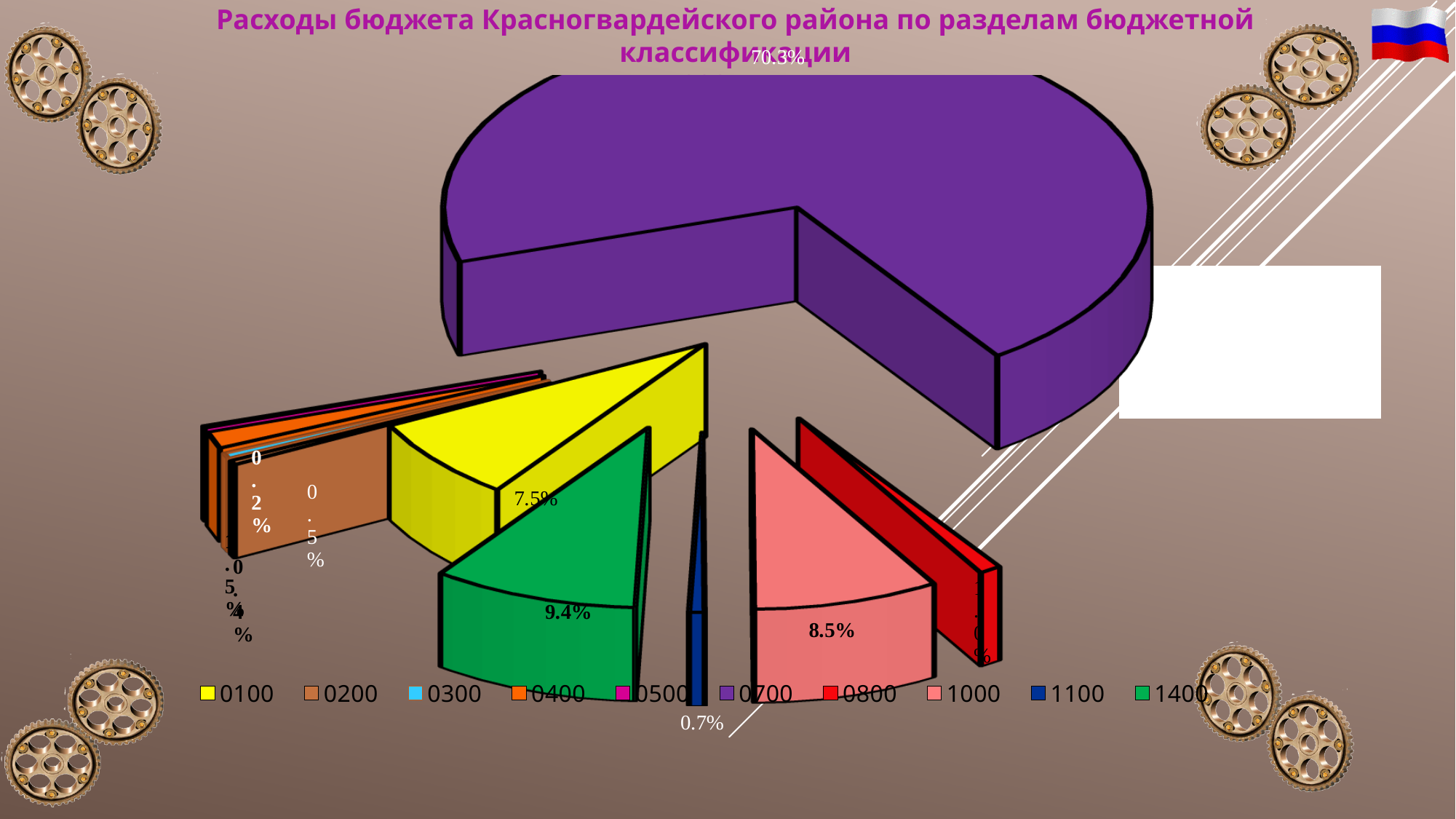
What kind of chart is shown on the slide? pie chart What share of the pie does category 1400 have? 9.4% What share of the pie does category 1000 have? 8.5% What is the difference between the shares of category 1400 and category 0100? 1.9% Which category has the largest slice of the pie? 0700 How many categories does the legend of the pie chart list? 10 Which category has the larger share, 1400 or 1000? 1400 What colour is the slice for category 0700? purple What share of the pie does category 0700 have? 70.3% What is the difference between the shares of category 0700 and category 1000? 61.8% What share of the pie does category 1100 have? 0.7% What share of the pie does category 0100 have? 7.5%